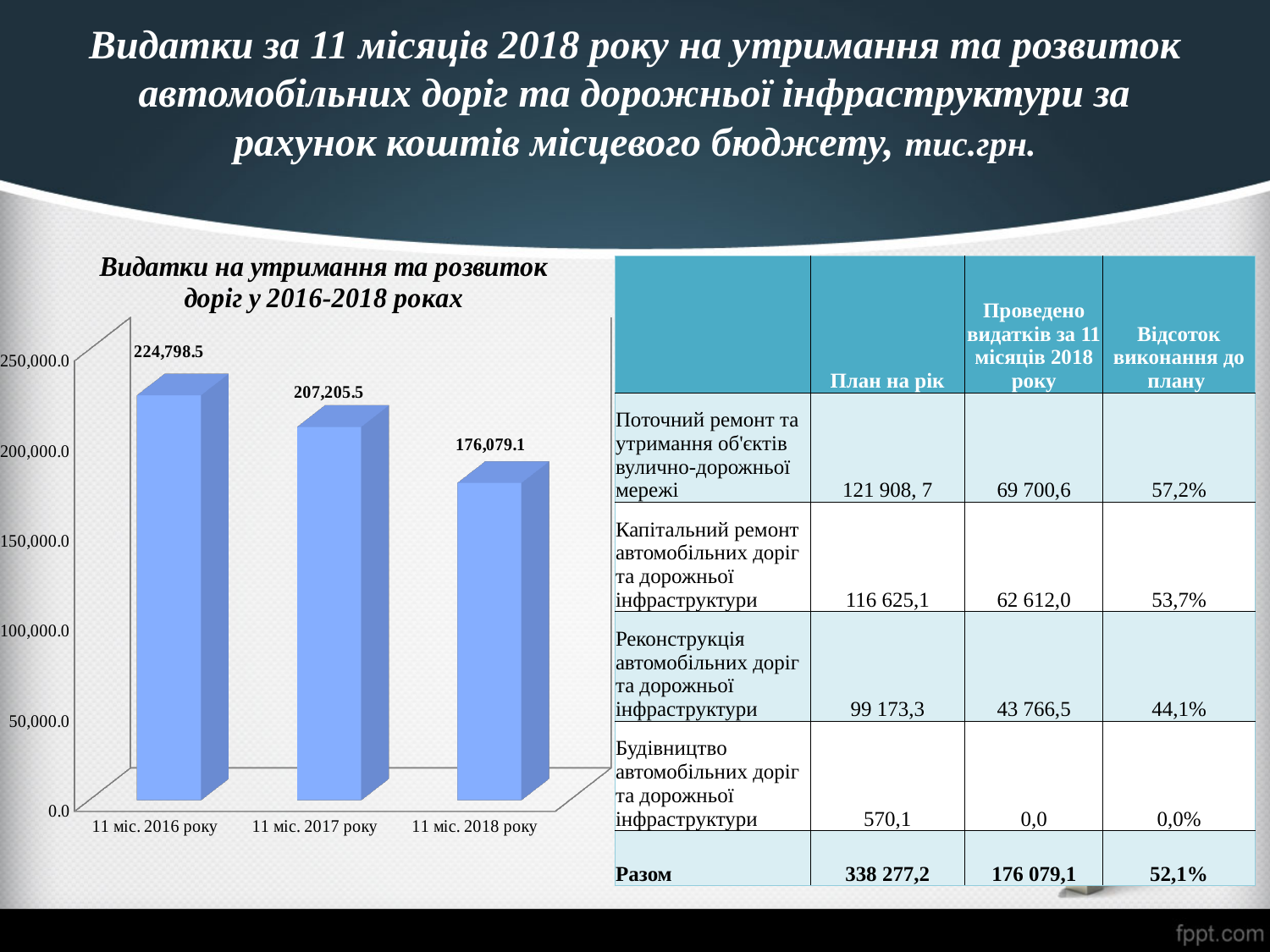
What is the value for 11 міс. 2018 року in the chart? 176,079.1 What is the value for 11 міс. 2017 року in the chart? 207,205.5 What kind of chart is shown on the slide? bar chart How many bars are shown in the chart? 3 What is the difference between the values for 11 міс. 2017 року and 11 міс. 2018 року? 31,126.4 What is the difference between the values for 11 міс. 2016 року and 11 міс. 2017 року? 17,593.0 Do the values rise or fall from 11 міс. 2016 року to 11 міс. 2018 року? fall Which category has the lowest value in the chart? 11 міс. 2018 року Which category has the highest value in the chart? 11 міс. 2016 року Is the value for 11 міс. 2018 року greater or less than 200,000.0? less Which is larger, the value for 11 міс. 2017 року or for 11 міс. 2018 року? 11 міс. 2017 року What is the value for 11 міс. 2016 року in the chart? 224,798.5